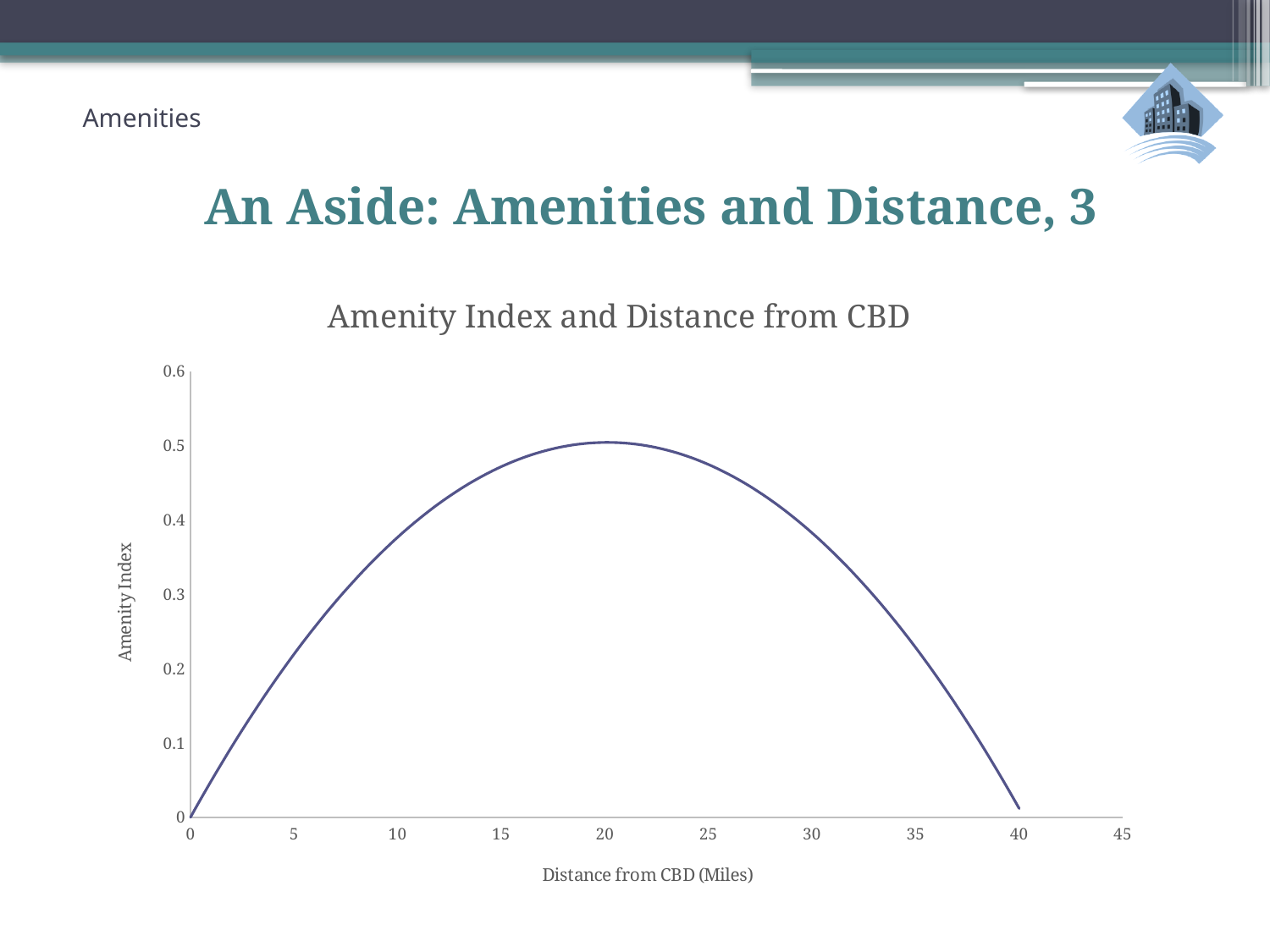
What is the label of the x axis of the chart? Distance from CBD (Miles) Is the Amenity Index at 20 miles from the CBD greater or less than 0.4? greater Which has the larger Amenity Index: 10 miles or 20 miles from the CBD? 20 miles What is the title of the chart? Amenity Index and Distance from CBD What kind of chart is shown on the slide? line chart What is the Amenity Index at a distance of 0 miles from the CBD? 0 Is the Amenity Index at 35 miles from the CBD greater or less than 0.1? greater Does the Amenity Index rise or fall as distance increases from 20 to 40 miles? fall Is the Amenity Index at 30 miles from the CBD greater or less than 0.4? less